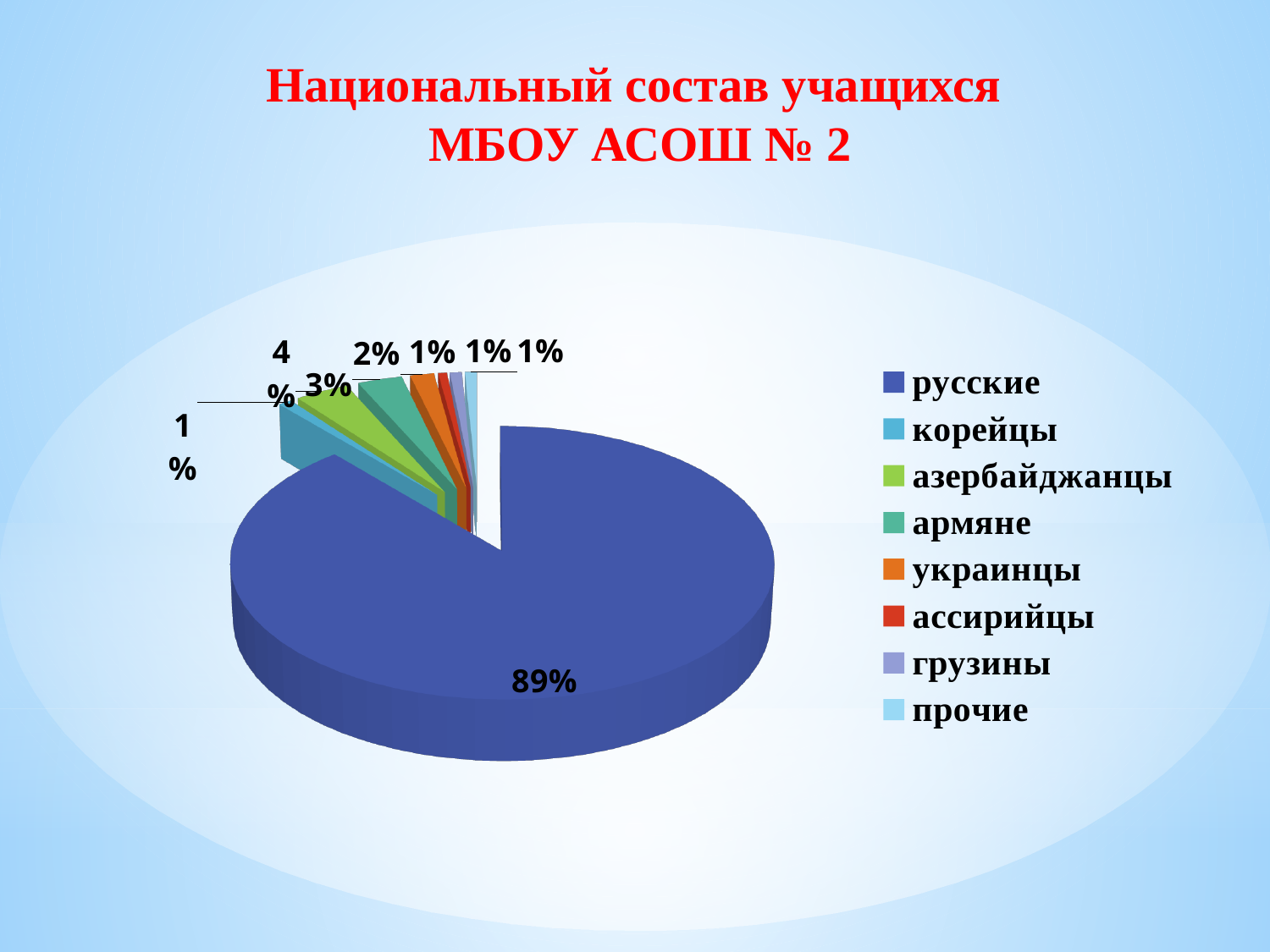
Which legend entry is listed last in the pie chart's legend? прочие What value is printed on the largest slice of the pie chart? 89% How many categories does the legend of the pie chart list? 8 Which category has the largest slice of the pie chart? русские Which is larger in the pie chart, the slice for русские or the slice for корейцы? русские What is the title of the chart on the slide? Национальный состав учащихся МБОУ АСОШ № 2 Which legend entry is listed first in the pie chart's legend? русские What share of the pie does the category русские have? 89% What kind of chart is shown on the slide? pie chart Which is larger in the pie chart, the slice for русские or the slice for армяне? русские